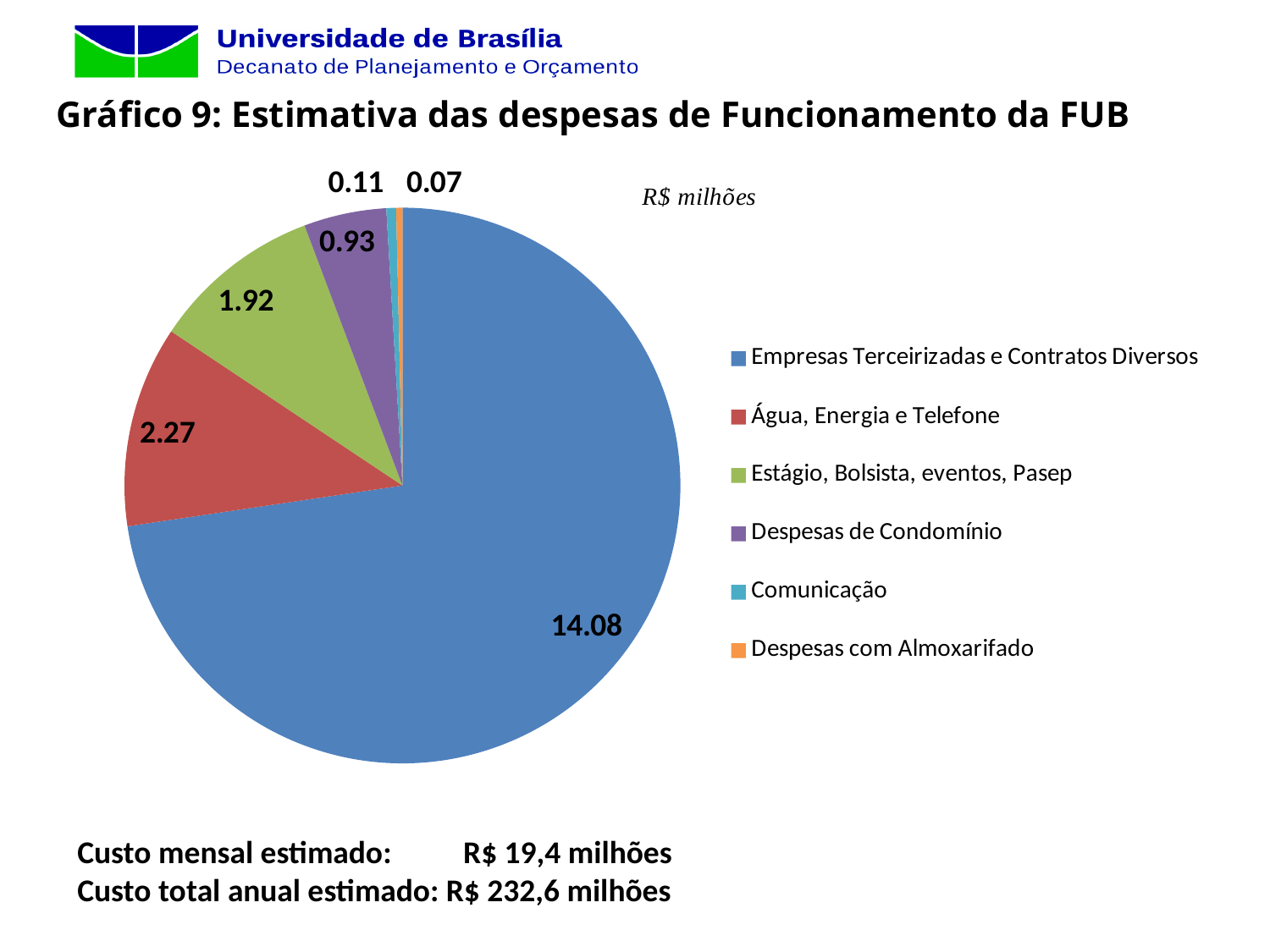
Which category has the largest slice of the pie? Empresas Terceirizadas e Contratos Diversos What type of chart is shown on the slide? Pie chart What is the value for Despesas de Condomínio? 0.93 How many categories does the legend list? 6 Which is larger, the value for Água, Energia e Telefone or the value for Estágio, Bolsista, eventos, Pasep? Água, Energia e Telefone What is the value for Empresas Terceirizadas e Contratos Diversos? 14.08 What is the difference between the values for Empresas Terceirizadas e Contratos Diversos and Água, Energia e Telefone? 11.81 Which category has the smallest slice of the pie? Despesas com Almoxarifado What unit is indicated for the values in the chart? R$ milhões What is the value for Despesas com Almoxarifado? 0.07 What is the value for Estágio, Bolsista, eventos, Pasep? 1.92 What is the value for Água, Energia e Telefone? 2.27